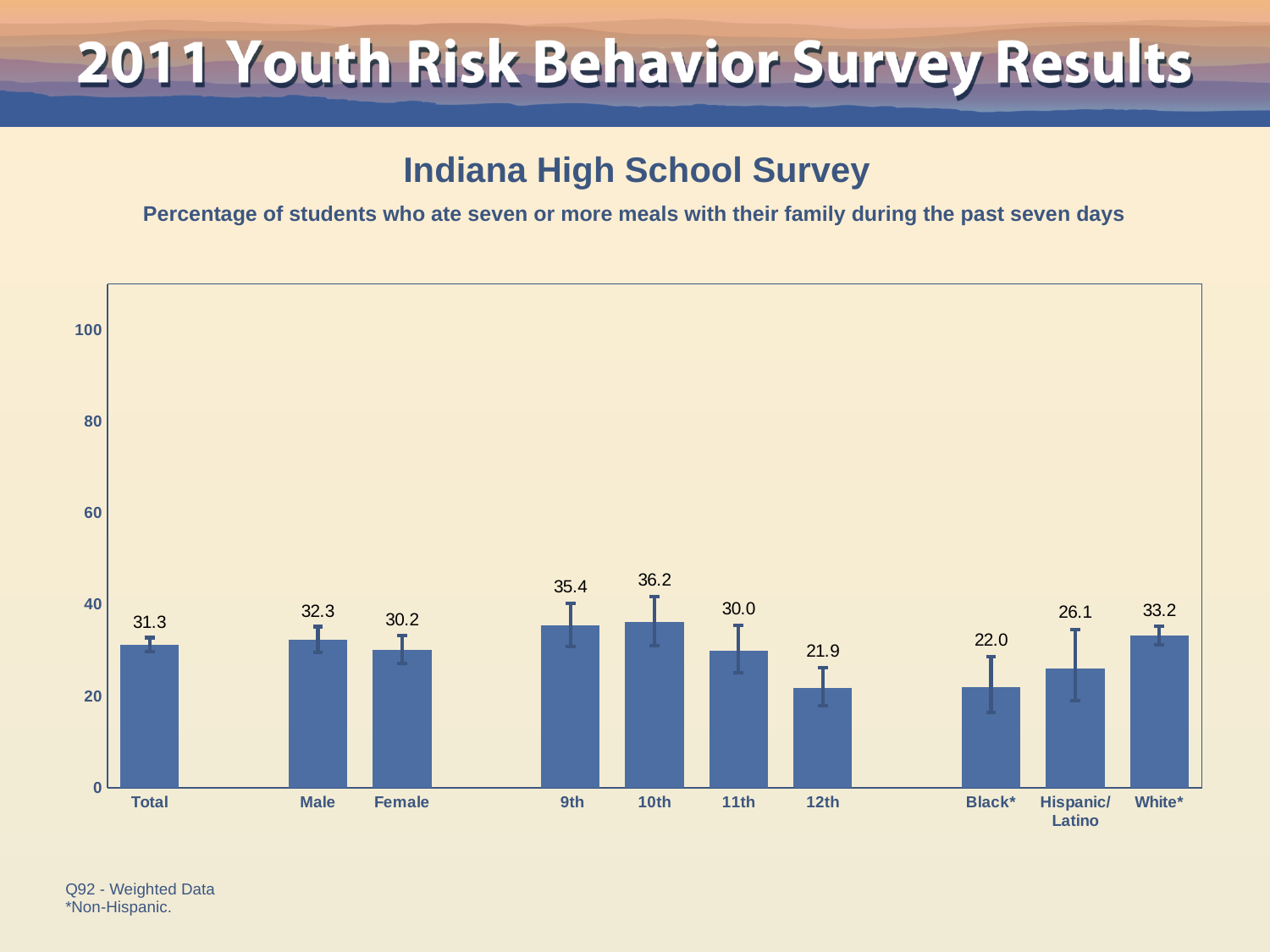
What is the value for Total? 31.3 Which category has the lowest value? 12th What is the value for Hispanic/Latino students? 26.1 How many categories are shown on the x axis? 10 Do the values rise or fall from 9th to 12th grade? They rise from 9th to 10th, then fall through 12th Which is larger, the value for 9th or the value for 11th? 9th What kind of chart is this? bar chart Is the value for 10th greater or less than 40? less Which category has the highest value? 10th What is the value for 12th grade students? 21.9 What is the difference between the values for White* and Black*? 11.2 What is the difference between the values for Male and Female? 2.1